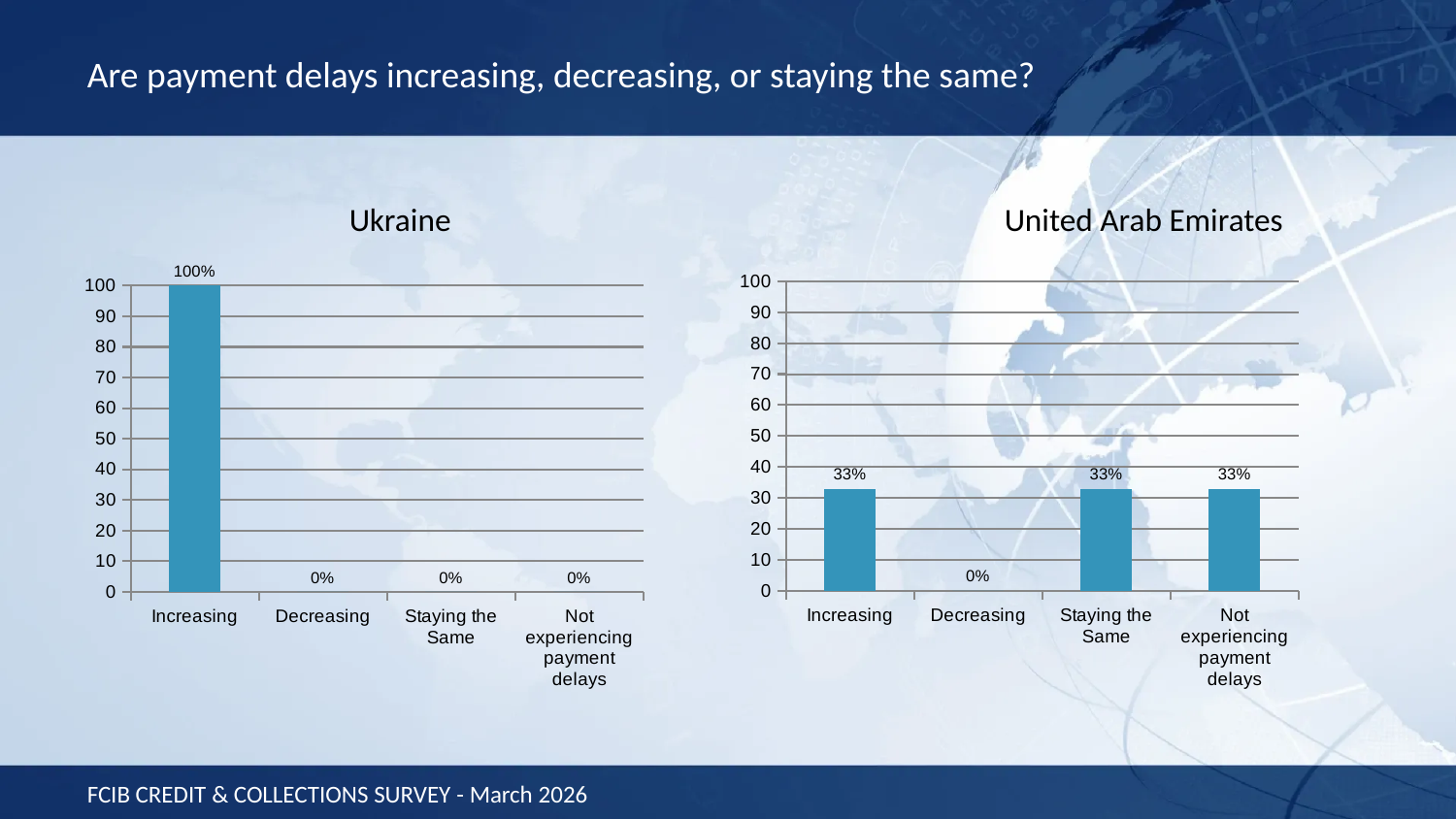
In the United Arab Emirates chart, is the value for Increasing greater or less than 50? less In the Ukraine chart, what is the value for Increasing? 100% What is the title of the chart on the left side of the slide? Ukraine In the United Arab Emirates chart, which is larger, the value for Increasing or the value for Decreasing? Increasing In the Ukraine chart, what is the difference between the values for Increasing and Staying the Same? 100% In the United Arab Emirates chart, what is the value for Staying the Same? 33% In the Ukraine chart, what is the value for Decreasing? 0% In the United Arab Emirates chart, which category has the lowest value? Decreasing What kind of chart is the United Arab Emirates chart? Bar chart In the United Arab Emirates chart, what is the value for Decreasing? 0% In the Ukraine chart, which category has the highest value? Increasing In the Ukraine chart, how many categories are shown on the x axis? 4